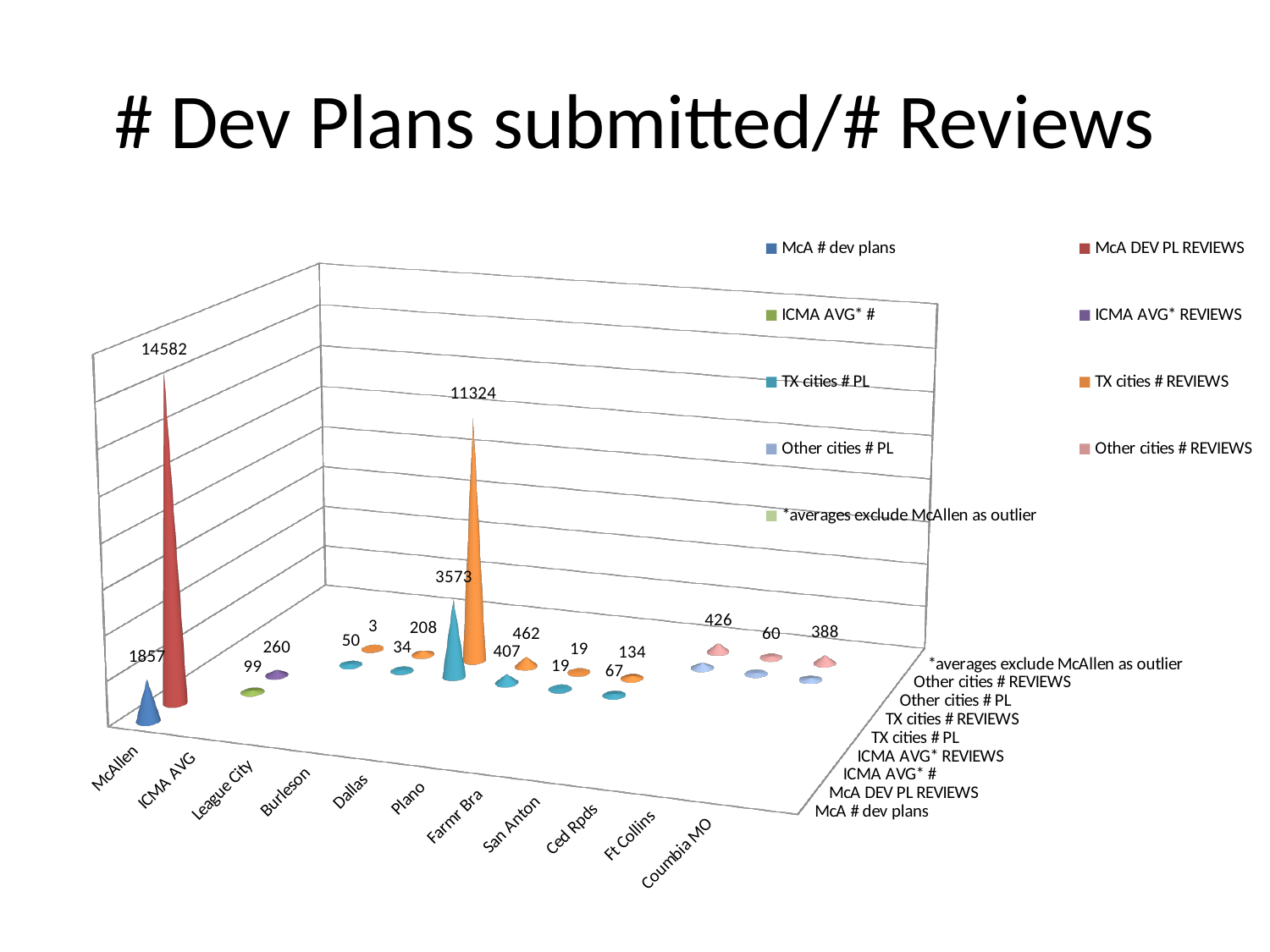
Which category has the highest value on the chart? McAllen What is the TX cities # PL value for Dallas? 3573 What is the TX cities # REVIEWS value for Dallas? 11324 What is the ICMA AVG* REVIEWS value shown for ICMA AVG? 260 What is the ICMA AVG* # value shown for ICMA AVG? 99 What is the value of McA DEV PL REVIEWS for McAllen? 14582 What is the difference between McAllen's McA DEV PL REVIEWS value and its McA # dev plans value? 12725 Which is larger: the ICMA AVG* REVIEWS value (260) or the ICMA AVG* # value (99)? ICMA AVG* REVIEWS What is the value of McA # dev plans for McAllen? 1857 How many entries does the legend list? 9 What is the title of the chart? # Dev Plans submitted/# Reviews How many categories are shown along the x axis? 11